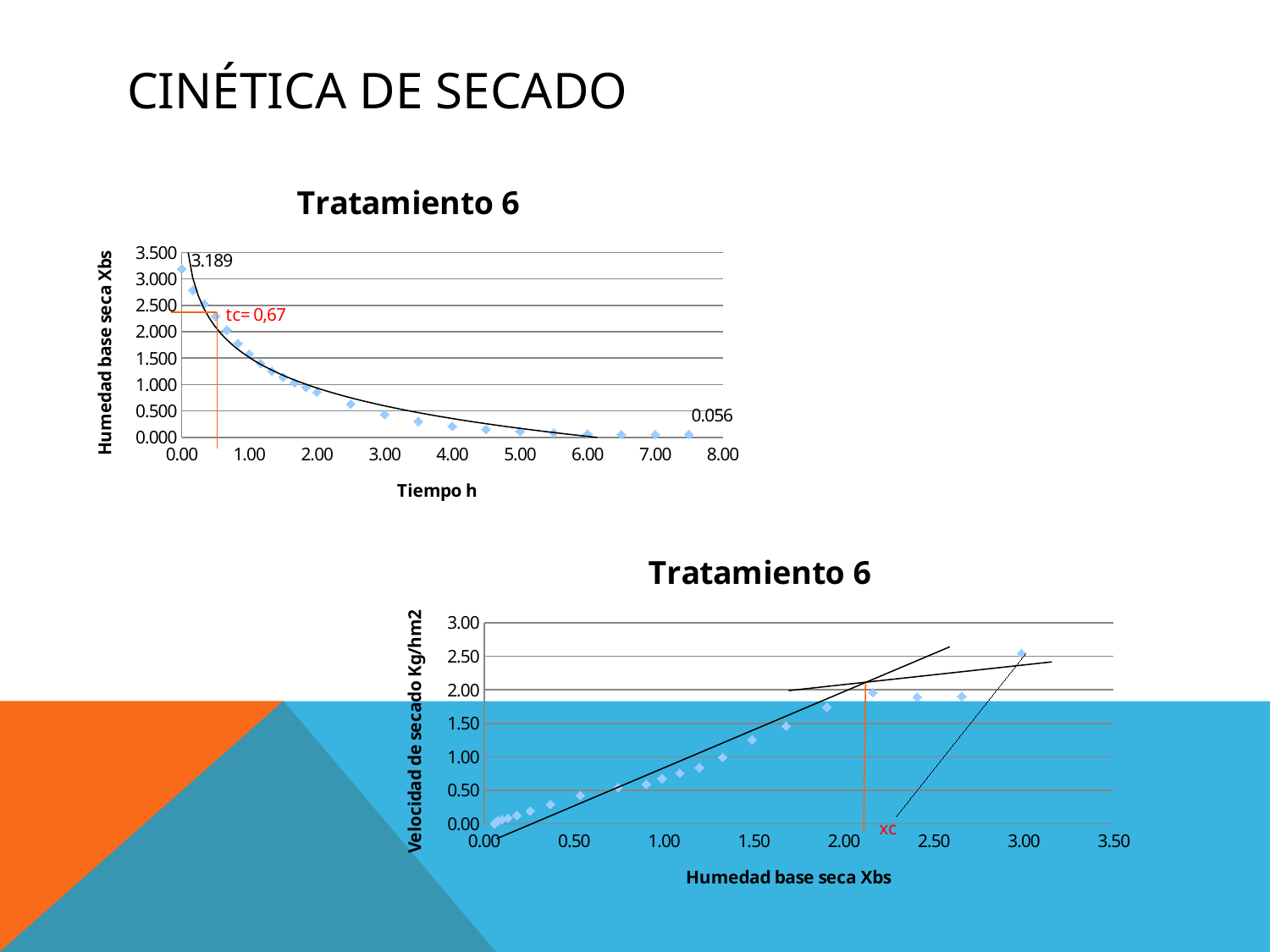
In the top chart, what is the labelled value of the last data point? 0.056 In the bottom chart, do the Velocidad de secado values rise or fall as Humedad base seca Xbs increases? rise In the top chart, is the value at 0.00 h greater or less than 3.000? greater In the bottom chart, is the value at Humedad base seca Xbs 3.00 greater or less than 2.00? greater What kind of chart is the bottom chart on the slide? scatter chart In the top chart, what is the labelled value of the first data point at time 0.00 h? 3.189 In the top chart, what is the difference between the labelled first value (3.189) and the labelled last value (0.056)? 3.133 In the top chart, do the Humedad base seca Xbs values rise or fall as Tiempo h increases? fall What is the y-axis title of the bottom chart? Velocidad de secado Kg/hm2 What kind of chart is the top chart on the slide? scatter chart In the top chart, is the value at 3.00 h greater or less than 1.000? less In the top chart, what value of tc is annotated in red? tc= 0,67